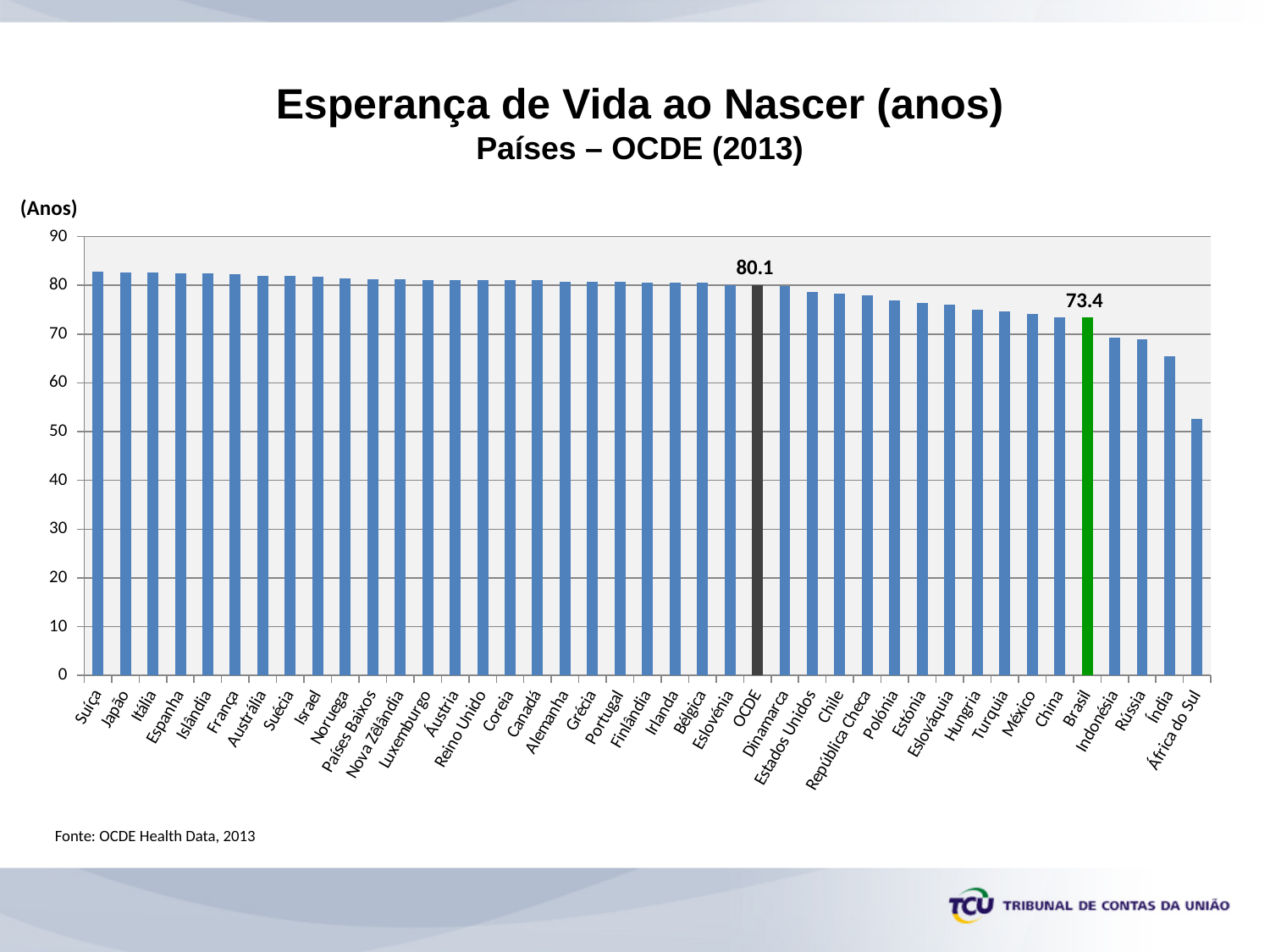
What is the difference between the OCDE value and the Brasil value? 6.7 Do the values rise or fall from left to right along the x axis? Fall Is the value for África do Sul greater or less than 60? less Which is larger, the value for Brasil or the value for OCDE? OCDE Which is larger, the value for Índia or the value for África do Sul? Índia What is the life expectancy value shown for OCDE? 80.1 Which country has the lowest life expectancy at birth in the chart? África do Sul What is the life expectancy value shown for Brasil? 73.4 What kind of chart is shown on the slide? Bar chart What colour is the bar for Brasil? Green Is the value for Índia greater or less than 70? less Is the value for Estados Unidos greater or less than 70? greater